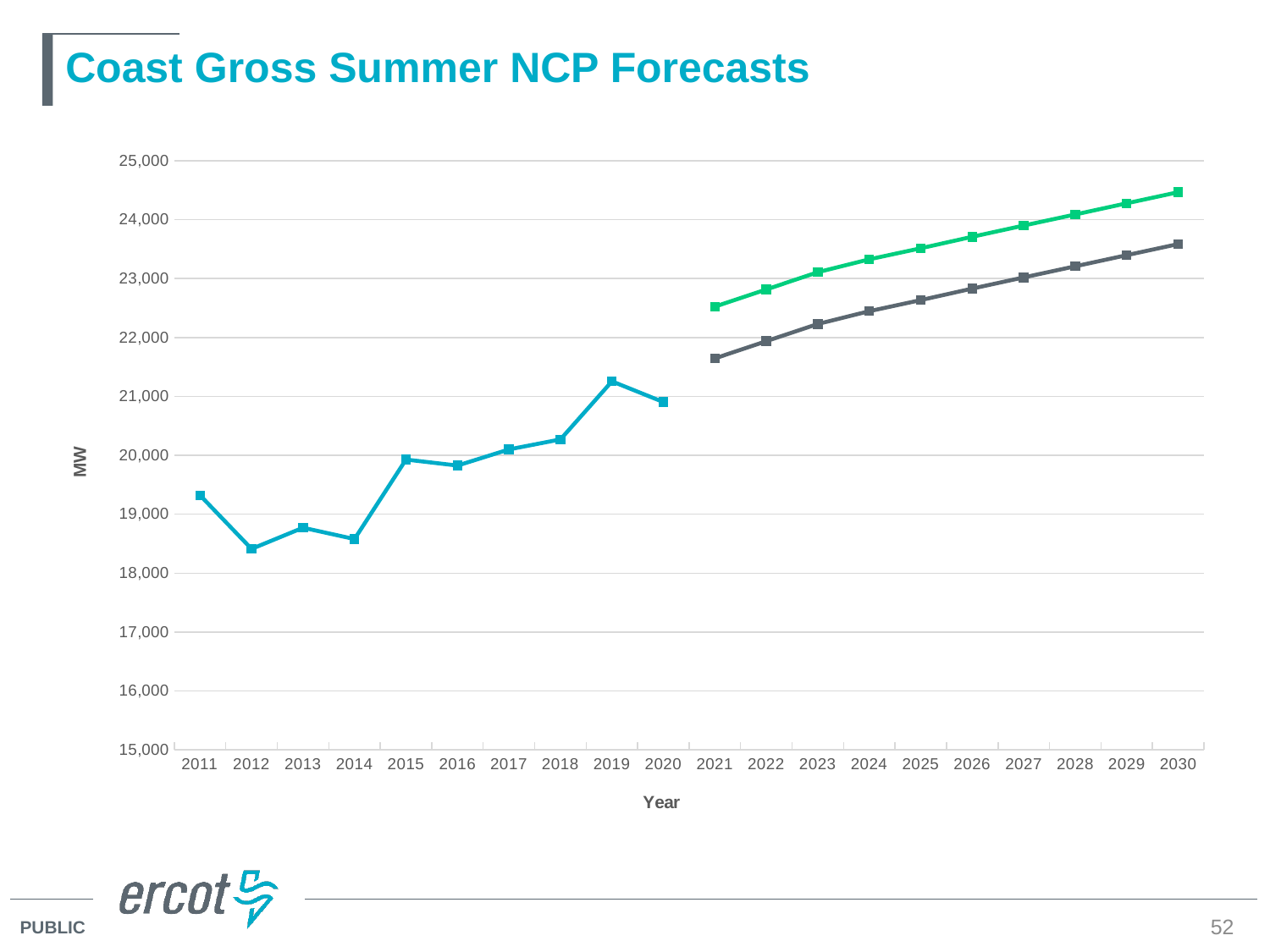
Which year has the lowest value on the blue line? 2012 In 2030, which line has the larger value, the green line or the dark gray line? green line What kind of chart is shown on the slide? line chart What is the label on the vertical axis of the chart? MW Is the value for 2021 on the dark gray line greater or less than 22,000? less Does the green line rise or fall from 2021 to 2030? rise Is the value for 2030 on the green line greater or less than 24,000? greater How many years are shown along the x axis of the chart? 20 Is the value for 2019 on the blue line greater or less than 21,000? greater What is the title of the chart? Coast Gross Summer NCP Forecasts Which year has the highest value on the blue line? 2019